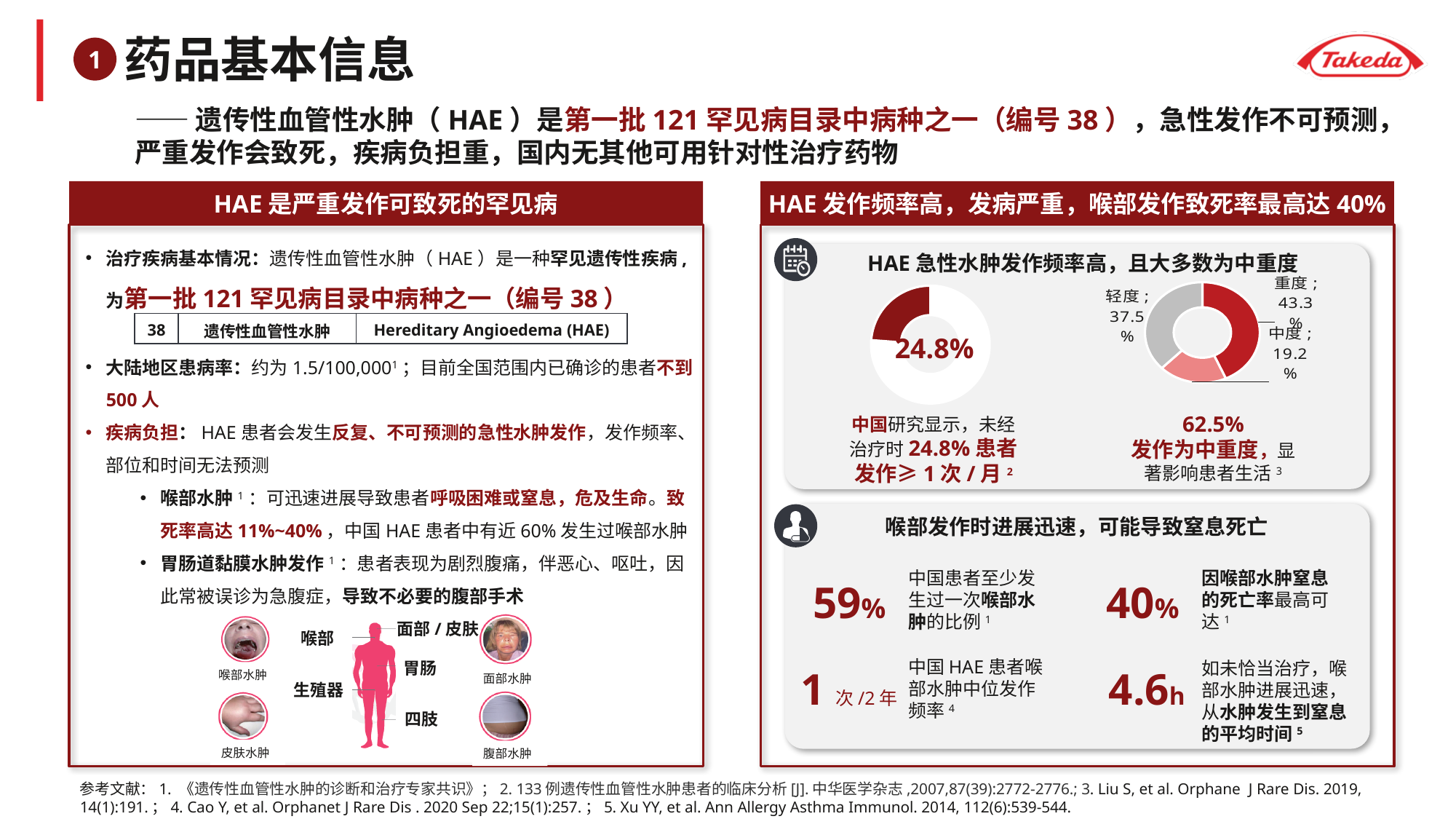
In the right donut chart showing severity of attacks, which category has the smallest share? 中度 In the right donut chart showing severity of attacks, which is larger: 轻度 or 中度? 轻度 In the right donut chart showing severity of attacks, what colour is the 轻度 slice? Grey In the right donut chart showing severity of attacks, which category has the largest share? 重度 In the right donut chart showing severity of attacks, what is the combined share of 中度 and 重度? 62.5% In the right donut chart showing severity of attacks, what is the difference between the 重度 and 中度 shares? 24.1 percentage points How many categories are shown in the right donut chart showing severity of attacks? 3 What kind of chart is used to show the severity distribution (轻度/中度/重度) on the slide? Donut (pie) chart In the right donut chart under 'HAE 急性水肿发作频率高，且大多数为中重度', what is the value for 重度? 43.3% In the left donut chart under 'HAE 急性水肿发作频率高，且大多数为中重度', what value is printed in the centre? 24.8% In the right donut chart under 'HAE 急性水肿发作频率高，且大多数为中重度', what is the value for 轻度? 37.5% In the right donut chart under 'HAE 急性水肿发作频率高，且大多数为中重度', what is the value for 中度? 19.2%